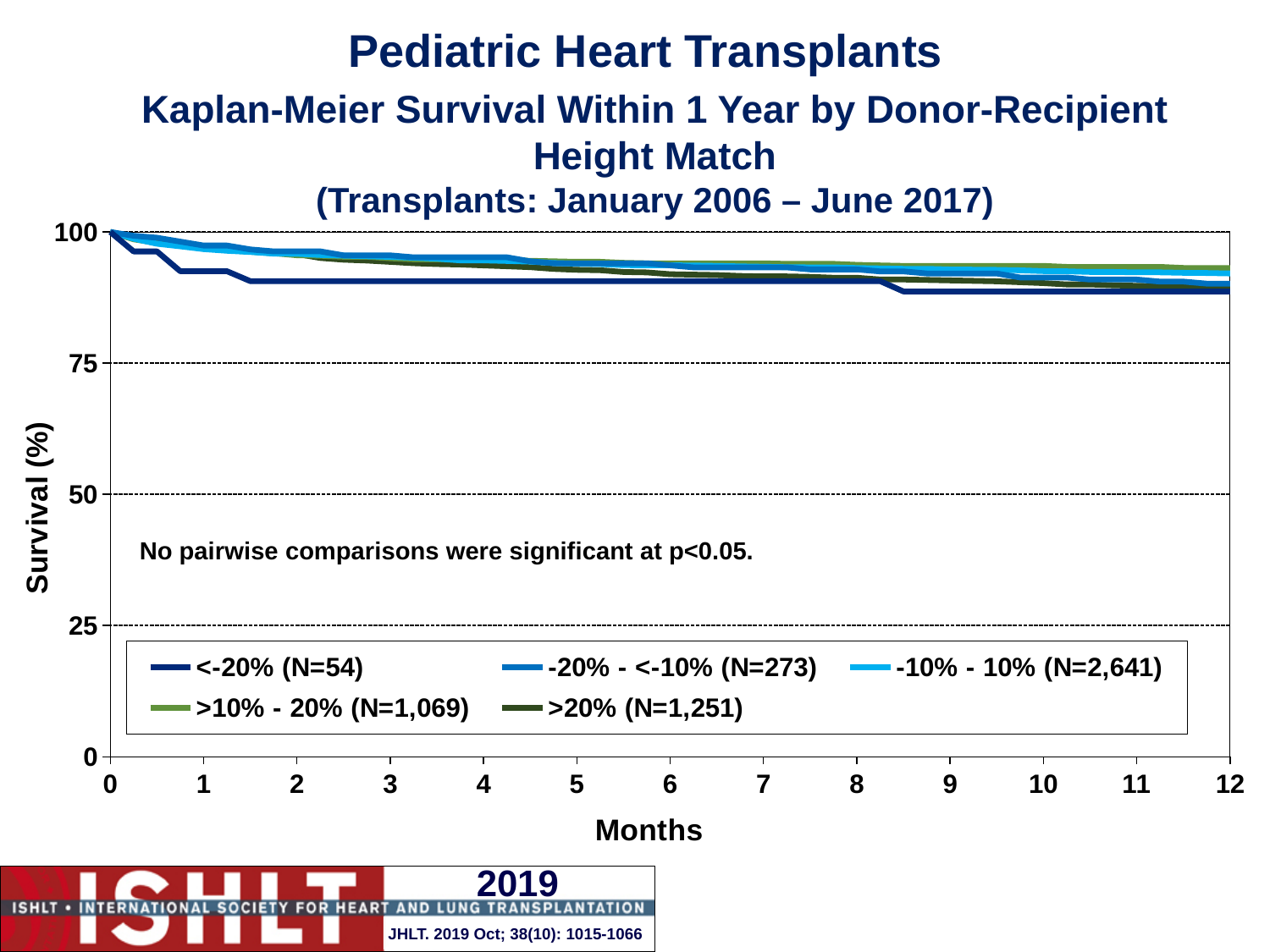
What kind of chart is shown on the slide? line chart What is the last month shown on the x axis? 12 Which group has the lowest survival at 2 months? <-20% (N=54) What is the highest value shown on the y axis? 100 What is the label of the y axis? Survival (%) Is the survival value for the <-20% (N=54) group at 12 months greater or less than 75? greater At 1 month, is the survival for the <-20% (N=54) group higher or lower than for the -10% - 10% (N=2,641) group? lower Do the survival curves rise or fall as months increase? fall Is the survival value for the >20% (N=1,251) group at 12 months greater or less than 50? greater Is the survival value for the -10% - 10% (N=2,641) group at 6 months greater or less than 75? greater How many series does the legend list? 5 What is the title of the chart? Pediatric Heart Transplants Kaplan-Meier Survival Within 1 Year by Donor-Recipient Height Match (Transplants: January 2006 – June 2017)